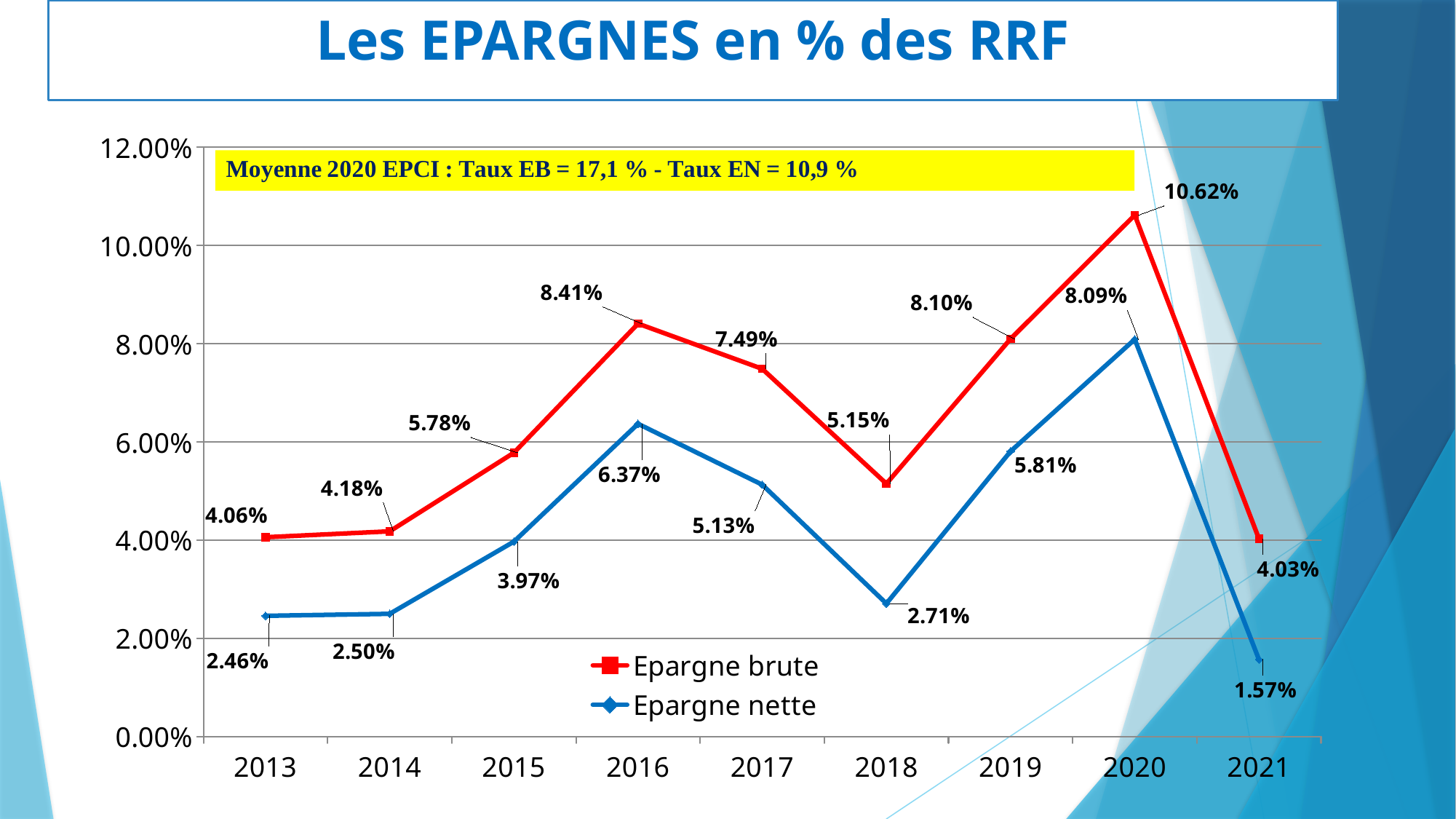
Is the value of Epargne nette in 2020 greater or less than 6.00%? greater What is the value of Epargne brute in 2020? 10.62% How many years are shown on the x axis? 9 How many series does the legend list? 2 In which year is Epargne nette lowest? 2021 What is the difference between Epargne brute and Epargne nette in 2016? 2.04% What is the value of Epargne nette in 2021? 1.57% Does Epargne brute rise or fall from 2020 to 2021? fall In which year is Epargne brute highest? 2020 What kind of chart is shown on the slide? line chart Which is larger: Epargne brute in 2019 or Epargne brute in 2017? Epargne brute in 2019 What is the value of Epargne nette in 2018? 2.71%